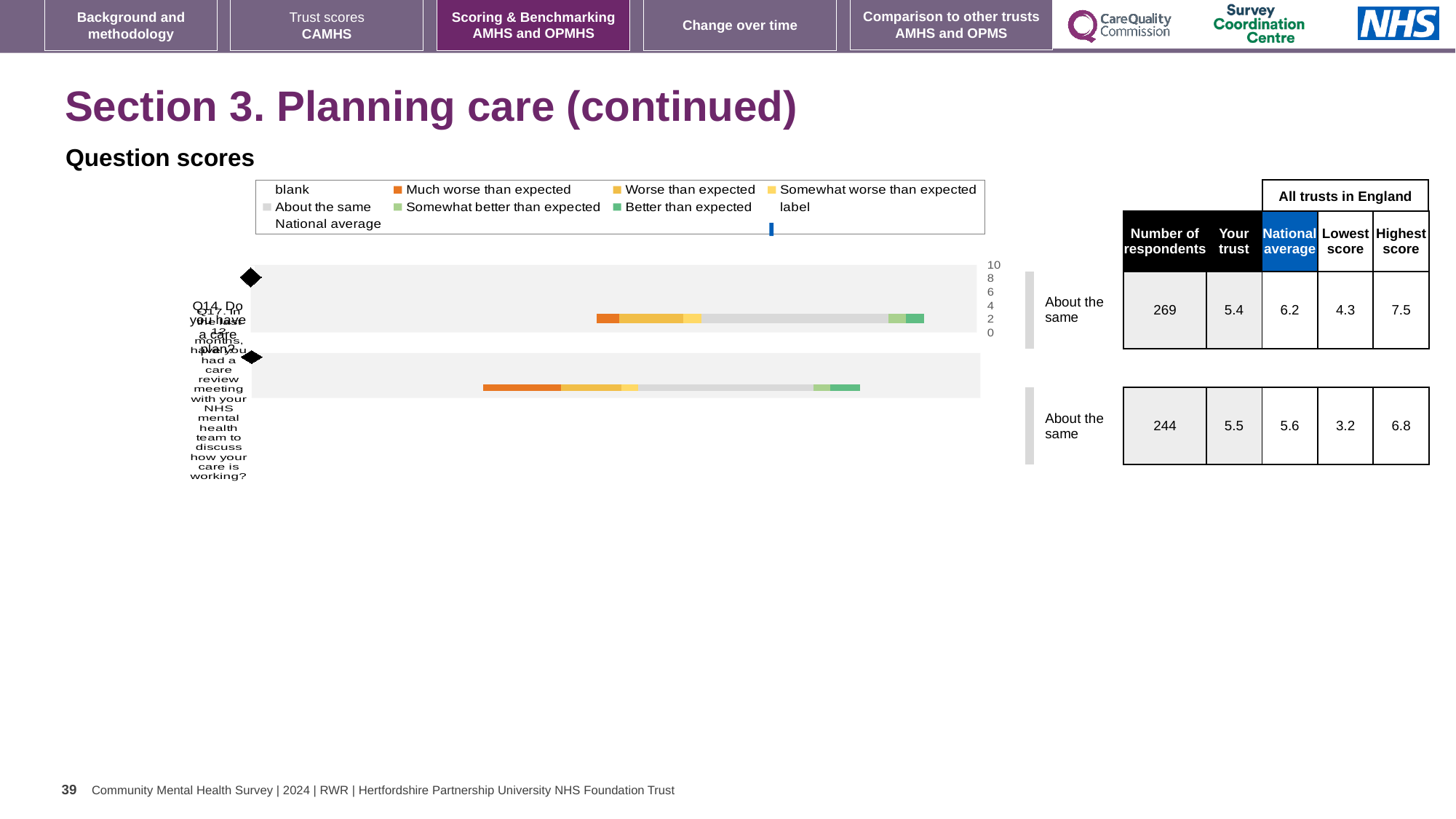
What benchmark category is shown next to both Q14 and Q17 bars? About the same According to the table beside the chart, how many respondents answered Q17? 244 According to the table beside the chart, how many respondents answered Q14? 269 Which two questions are plotted in the chart? Q14 and Q17 According to the table beside the chart, what is the national average for Q14? 6.2 How many question bars are plotted in the chart? 2 According to the table beside the chart, what is the national average for Q17? 5.6 According to the table beside the chart, what is the 'Your trust' score for Q14 (Do you have a care plan?)? 5.4 According to the table beside the chart, what is the 'Your trust' score for Q17 (care review meeting)? 5.5 What kind of chart is shown under 'Question scores'? bar chart What colour does the legend use for 'Much worse than expected'? orange Which question has the higher 'Your trust' score in the table beside the chart, Q14 or Q17? Q17